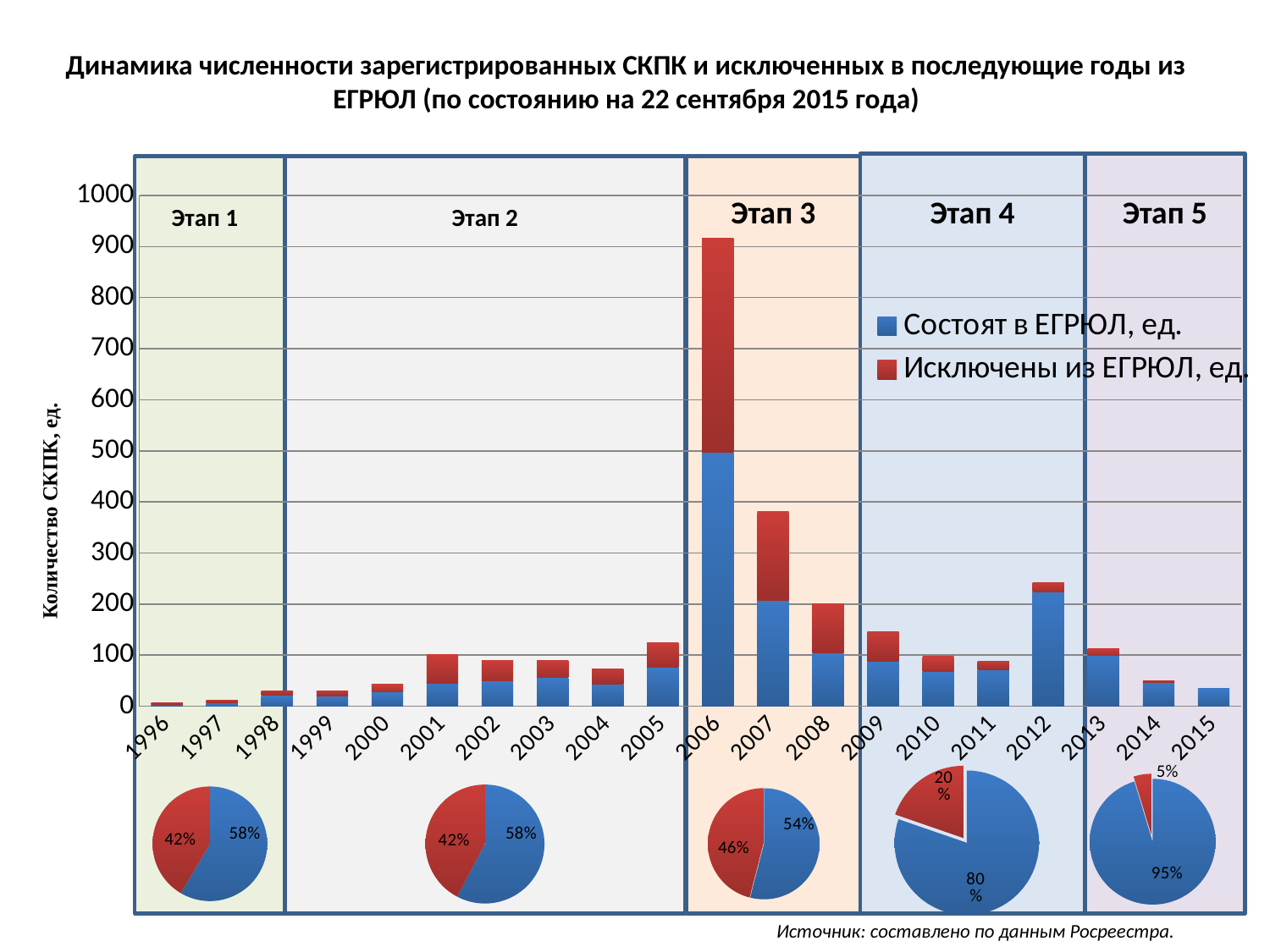
In the bar chart, is the total value for 2006 greater or less than 800? greater In the pie chart under Этап 5, what share is shown for the blue slice (Состоят в ЕГРЮЛ)? 95% How many series does the legend of the bar chart list? 2 In the bar chart, which total bar is larger, 2007 or 2008? 2007 In the bar chart, do the total values rise or fall from 2006 to 2008? fall What kind of chart is the main chart showing the years 1996 to 2015? bar chart In the bar chart, which year has the highest total bar? 2006 In the bar chart, is the total value for 2007 greater or less than 300? greater In the pie chart under Этап 3, what share is shown for the red slice (Исключены из ЕГРЮЛ)? 46% In the bar chart, is the value for 2015 greater or less than 100? less In the pie chart under Этап 4, what share is shown for the red slice (Исключены из ЕГРЮЛ)? 20% How many years are shown on the x axis of the bar chart? 20